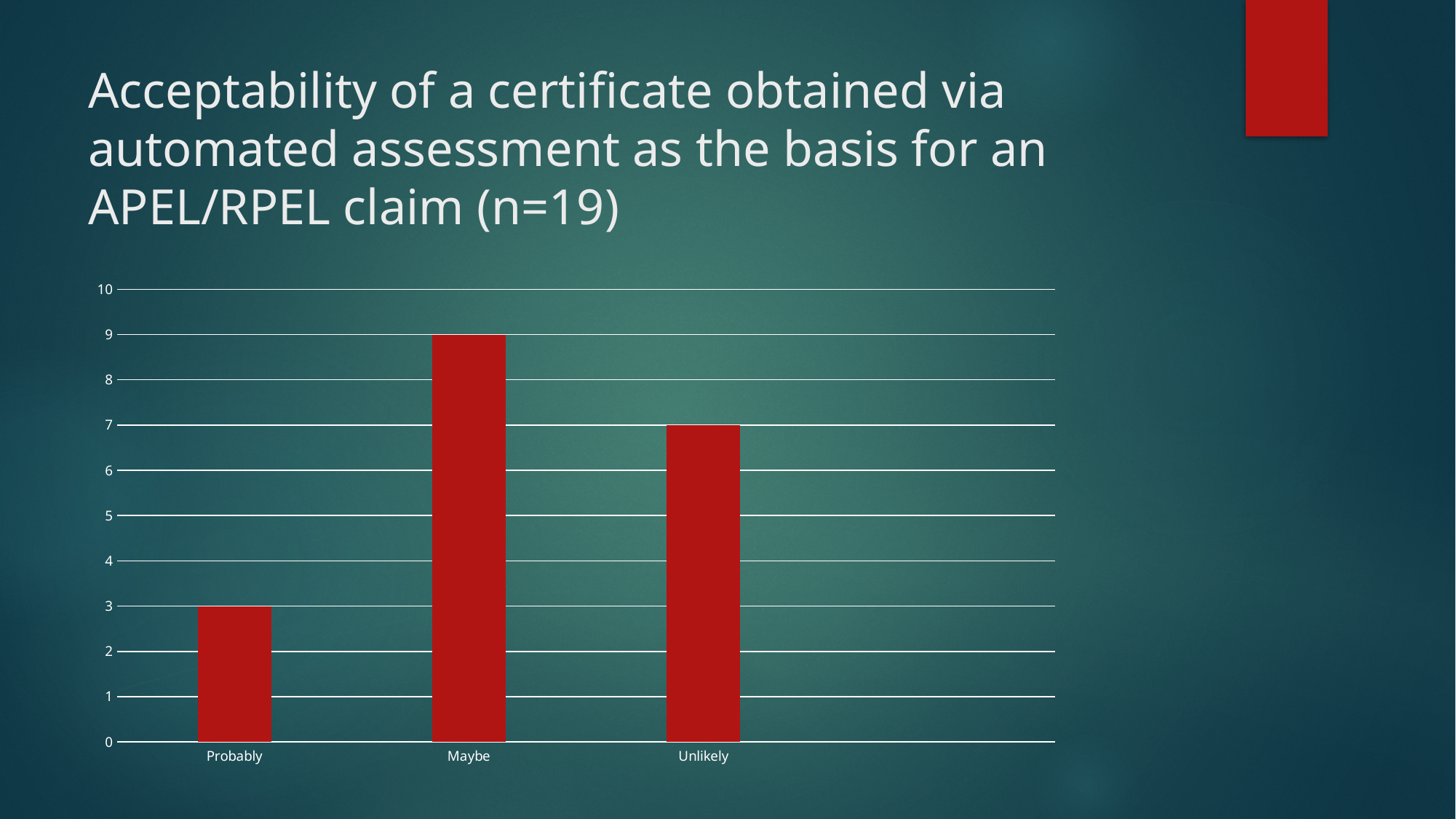
Is the value for Maybe greater or less than 5? greater What is the value for Unlikely? 7 What is the value for Maybe? 9 Which category has the lowest value? Probably How many categories are shown on the x axis? 3 What is the difference between the values for Unlikely and Probably? 4 What is the difference between the values for Maybe and Unlikely? 2 Which category has the highest value? Maybe What is the value for Probably? 3 What is the sample size stated in the chart title? n=19 What kind of chart is shown on the slide? bar chart Which is larger, the value for Probably or the value for Unlikely? Unlikely